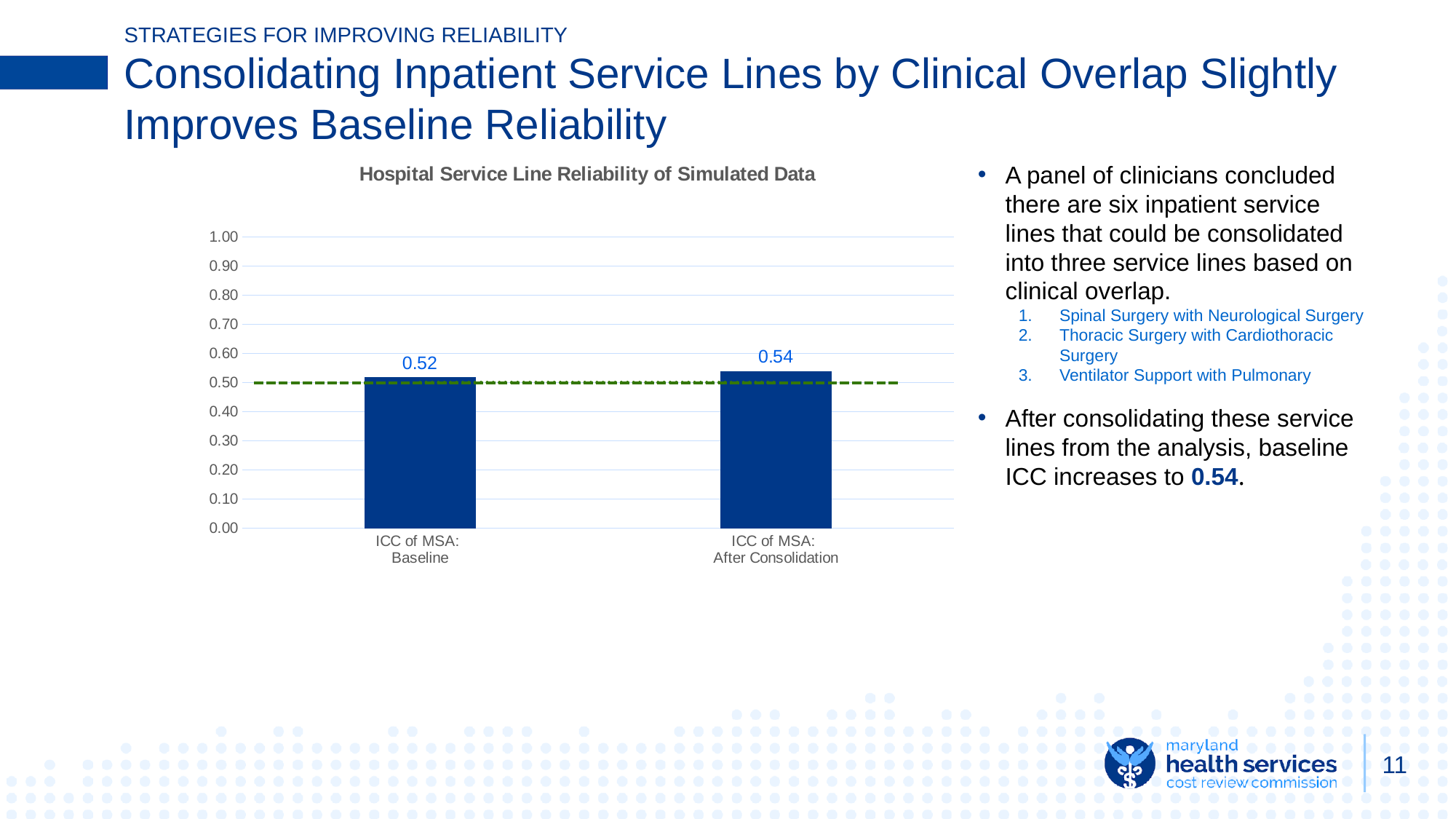
What kind of chart is shown on the slide? Bar chart Which category has the highest value? ICC of MSA: After Consolidation Which is larger, the value for ICC of MSA: Baseline or ICC of MSA: After Consolidation? ICC of MSA: After Consolidation What is the title of the chart? Hospital Service Line Reliability of Simulated Data Is the value for ICC of MSA: Baseline greater or less than 0.50? greater How many bars are plotted in the chart? 2 What is the value for ICC of MSA: Baseline? 0.52 Is the value for ICC of MSA: After Consolidation greater or less than 0.60? less What is the difference between the After Consolidation value and the Baseline value? 0.02 Which category has the lowest value? ICC of MSA: Baseline What is the value for ICC of MSA: After Consolidation? 0.54 Do the values rise or fall from Baseline to After Consolidation? Rise